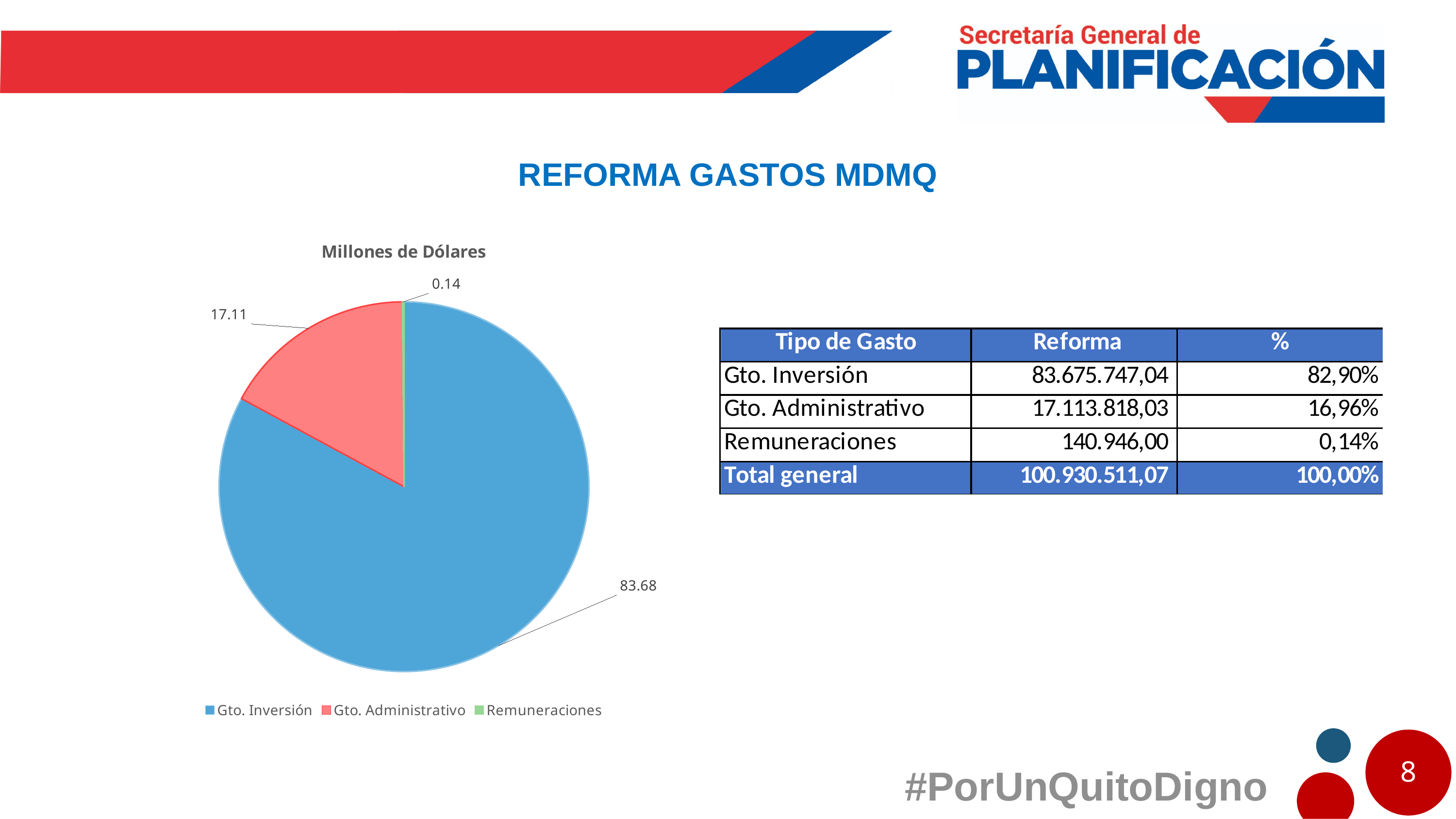
Which category has the largest slice in the pie chart? Gto. Inversión What is the difference between the values for Gto. Inversión and Gto. Administrativo in the pie chart? 66.57 What is the value for Gto. Administrativo in the pie chart? 17.11 Which category has the smallest slice in the pie chart? Remuneraciones What is the value for Gto. Inversión in the pie chart? 83.68 How many slices does the pie chart have? 3 What type of chart is shown on the slide? Pie chart What is the title of the pie chart? Millones de Dólares What colour is the Gto. Administrativo slice in the pie chart? Red What is the value for Remuneraciones in the pie chart? 0.14 Which is larger in the pie chart, Gto. Administrativo or Remuneraciones? Gto. Administrativo What is the difference between the values for Gto. Administrativo and Remuneraciones in the pie chart? 16.97